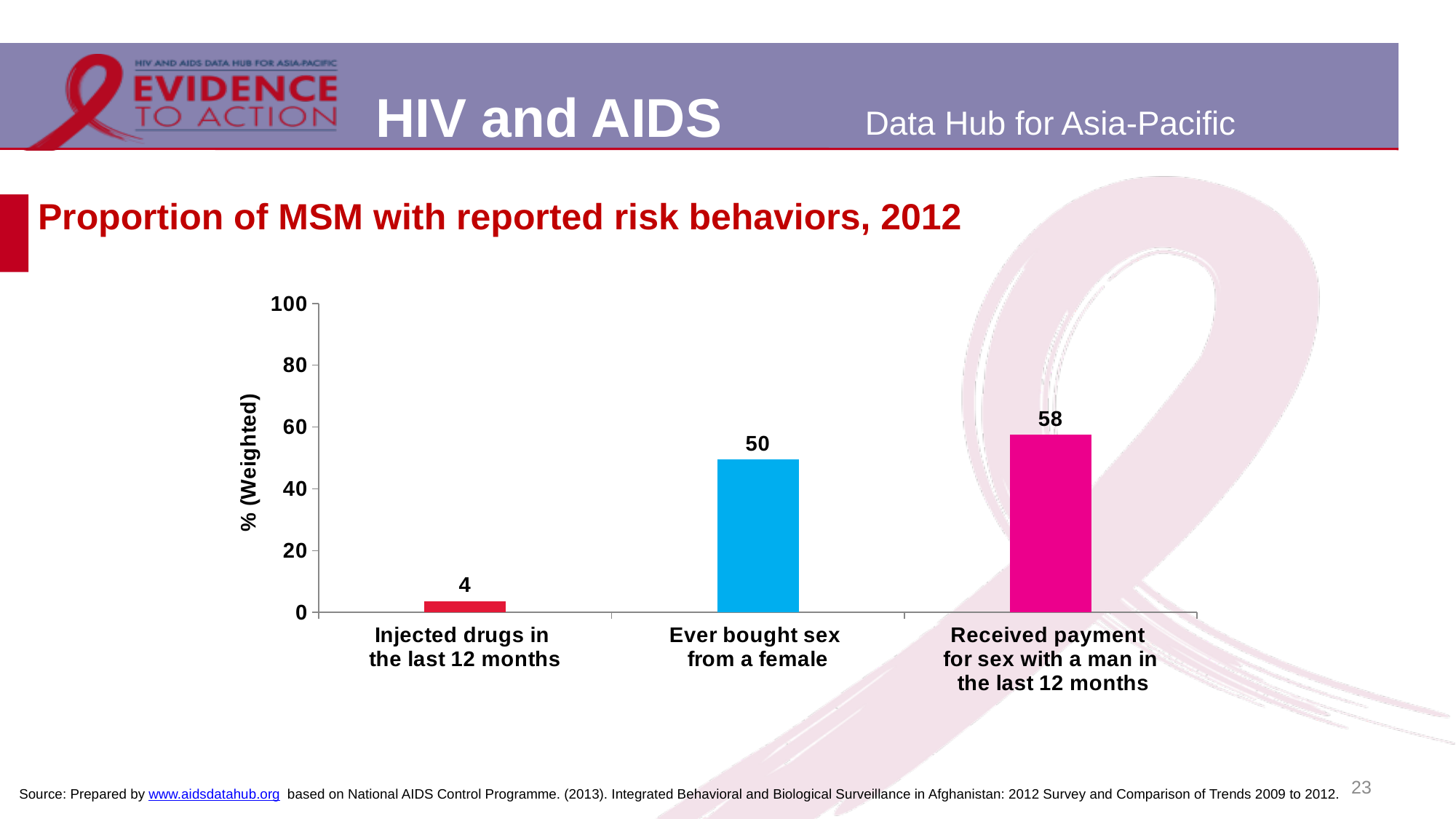
Is the value for 'Received payment for sex with a man in the last 12 months' greater or less than 40? greater What is the difference between the values for 'Received payment for sex with a man in the last 12 months' and 'Ever bought sex from a female'? 8 Which category has the lowest value? Injected drugs in the last 12 months Which category has the highest value? Received payment for sex with a man in the last 12 months What is the value for 'Received payment for sex with a man in the last 12 months'? 58 What kind of chart is shown on the slide? Bar chart What is the label of the vertical axis? % (Weighted) What is the value for 'Ever bought sex from a female'? 50 Which is larger: the value for 'Ever bought sex from a female' or 'Injected drugs in the last 12 months'? Ever bought sex from a female How many categories are shown in the chart? 3 What is the difference between the values for 'Ever bought sex from a female' and 'Injected drugs in the last 12 months'? 46 What is the value for 'Injected drugs in the last 12 months'? 4